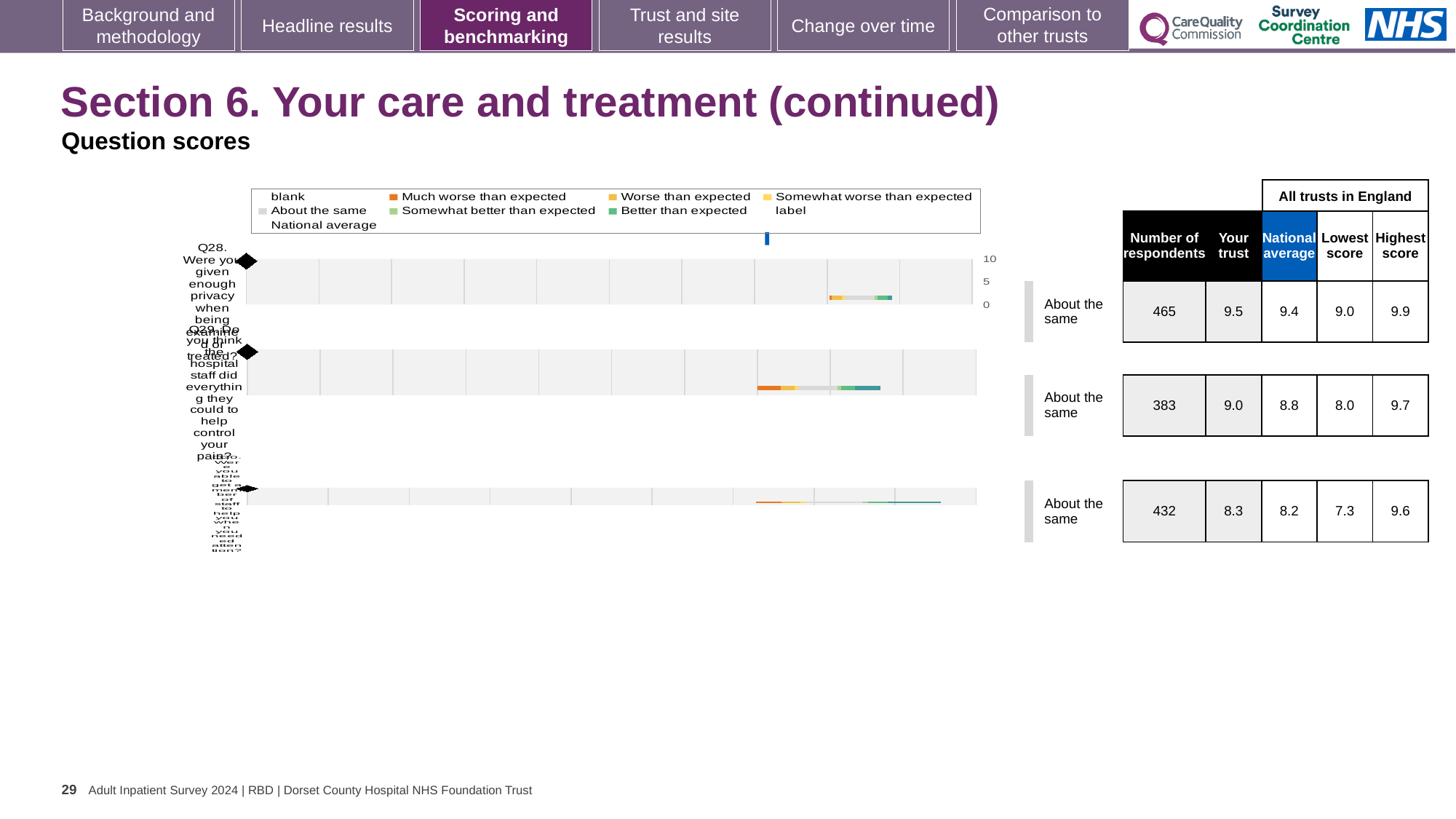
What is the 'Your trust' score for Q28 (privacy when being examined or treated)? 9.5 What is the lowest score among all trusts in England for Q30? 7.3 What is the highest score among all trusts in England for Q28? 9.9 What is the national average score for Q29 (staff did everything to help control pain)? 8.8 What benchmark category is shown next to the chart for Q30? About the same How many questions are plotted on this slide? 3 What is the difference between the 'Your trust' score and the national average for Q29? 0.2 What kind of chart is used to show the question scores? Bar chart How many respondents answered Q30? 432 Which question has the highest 'Your trust' score? Q28 Which question has the lowest national average score? Q30 For Q28, which is larger: the 'Your trust' score or the national average? Your trust